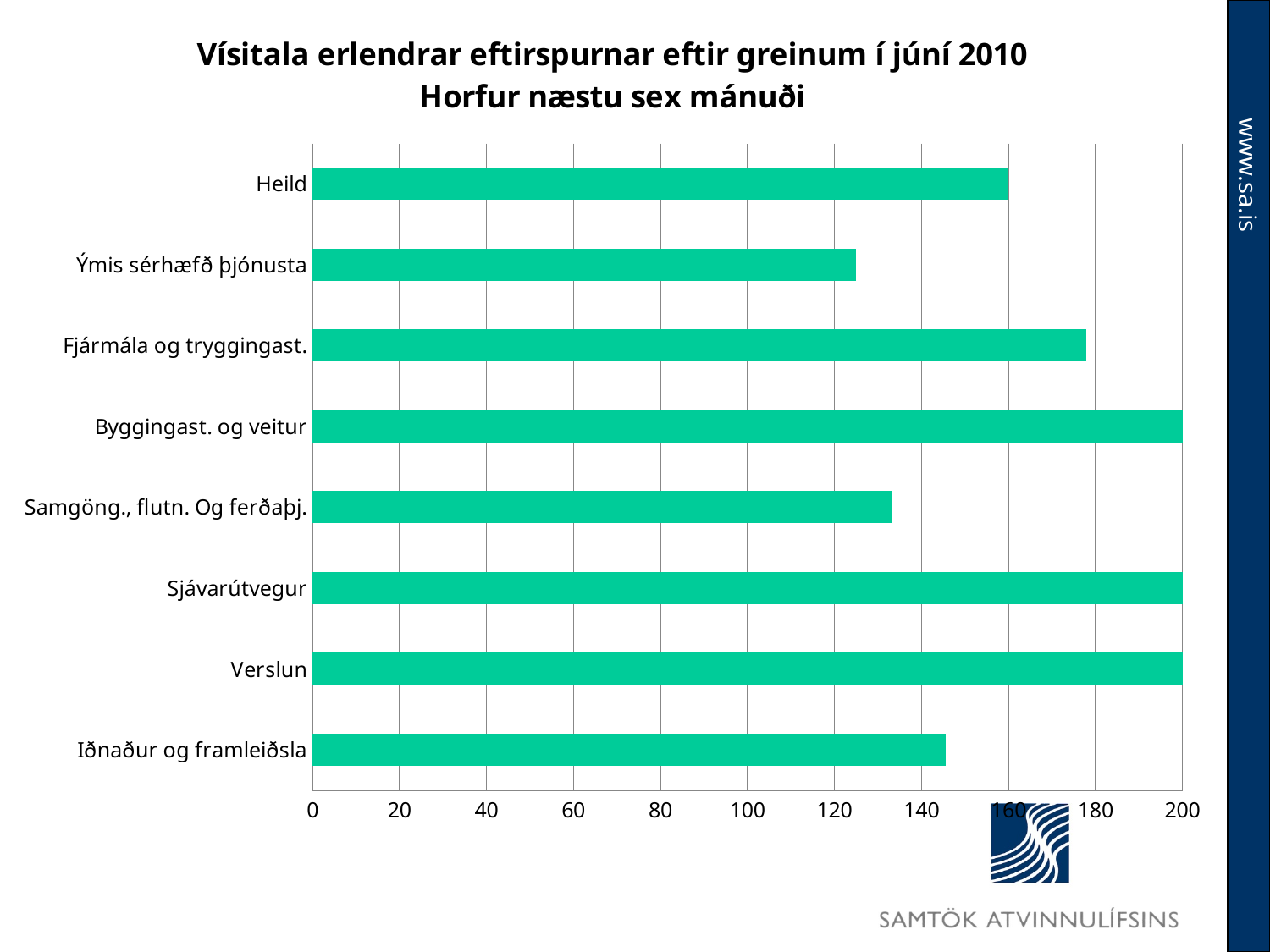
Is the value for Fjármála og tryggingast. greater or less than 160? greater What is the value for Byggingast. og veitur? 200 Which is larger, the value for Fjármála og tryggingast. or the value for Ýmis sérhæfð þjónusta? Fjármála og tryggingast. Is the value for Ýmis sérhæfð þjónusta greater or less than 140? less What is the title of the chart? Vísitala erlendrar eftirspurnar eftir greinum í júní 2010 Horfur næstu sex mánuði Is the value for Samgöng., flutn. Og ferðaþj. greater or less than 140? less What is the value for Heild? 160 What kind of chart is shown on the slide? Bar chart How many categories are plotted on the chart? 8 What is the value for Sjávarútvegur? 200 What is the value for Verslun? 200 Which category has the lowest value? Ýmis sérhæfð þjónusta